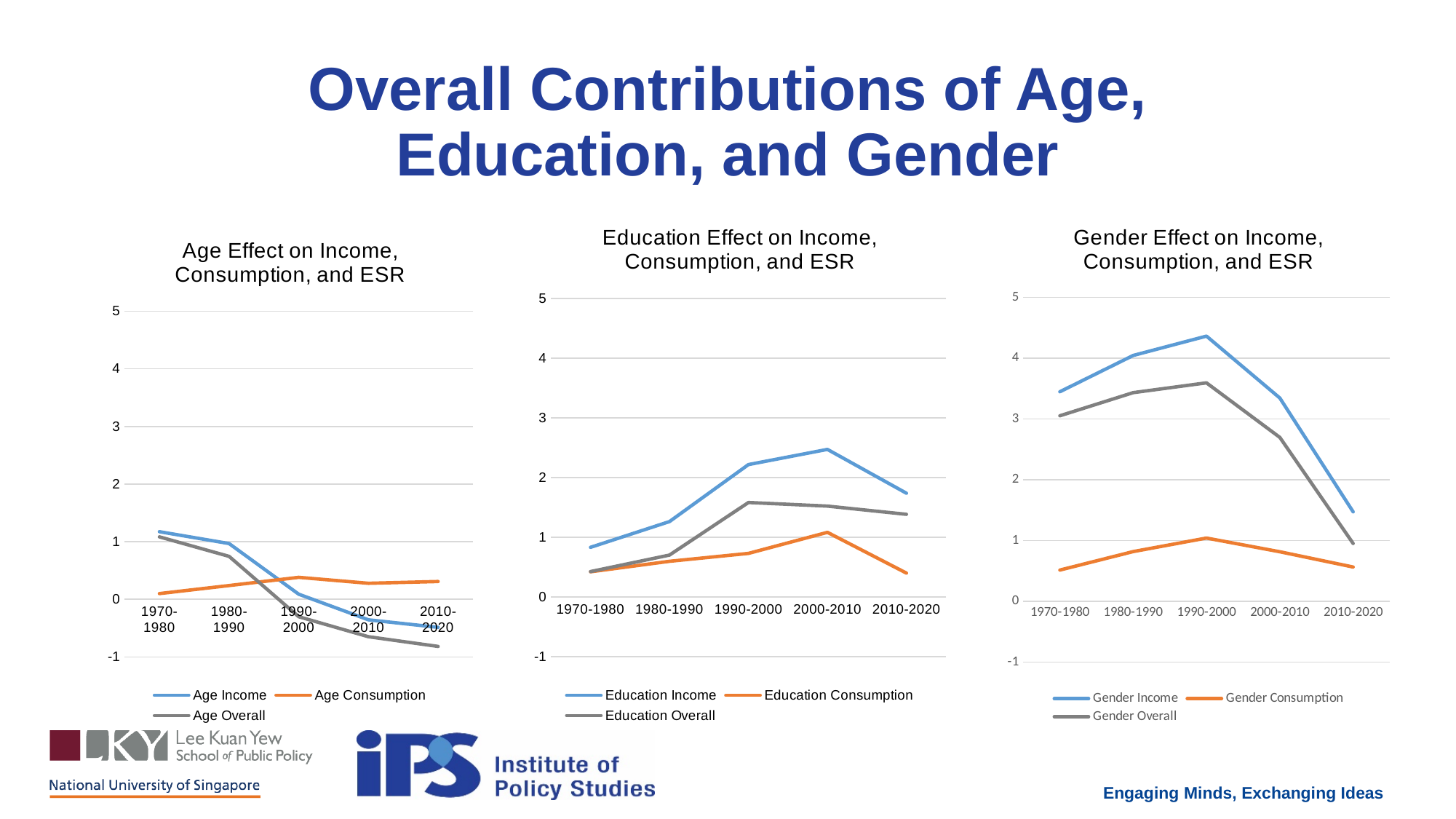
In the "Gender Effect on Income, Consumption, and ESR" chart, which is larger in 1990-2000: Gender Income or Gender Consumption? Gender Income In the "Age Effect on Income, Consumption, and ESR" chart, how many time periods are shown on the x axis? 5 In the "Education Effect on Income, Consumption, and ESR" chart, which period has the highest Education Income value? 2000-2010 In the "Age Effect on Income, Consumption, and ESR" chart, is the Age Income value for 1970-1980 greater or less than 1? greater In the "Age Effect on Income, Consumption, and ESR" chart, does the Age Income line rise or fall from 1970-1980 to 2010-2020? Fall What kind of chart is the "Age Effect on Income, Consumption, and ESR" chart? Line chart In the "Age Effect on Income, Consumption, and ESR" chart, how many series does the legend list? 3 In the "Gender Effect on Income, Consumption, and ESR" chart, is the Gender Income value for 2010-2020 greater or less than 2? less In the "Gender Effect on Income, Consumption, and ESR" chart, which period has the highest Gender Income value? 1990-2000 In the "Gender Effect on Income, Consumption, and ESR" chart, which period has the lowest Gender Overall value? 2010-2020 In the "Education Effect on Income, Consumption, and ESR" chart, is the Education Income value for 2000-2010 greater or less than 2? greater In the "Age Effect on Income, Consumption, and ESR" chart, which period has the highest Age Overall value? 1970-1980